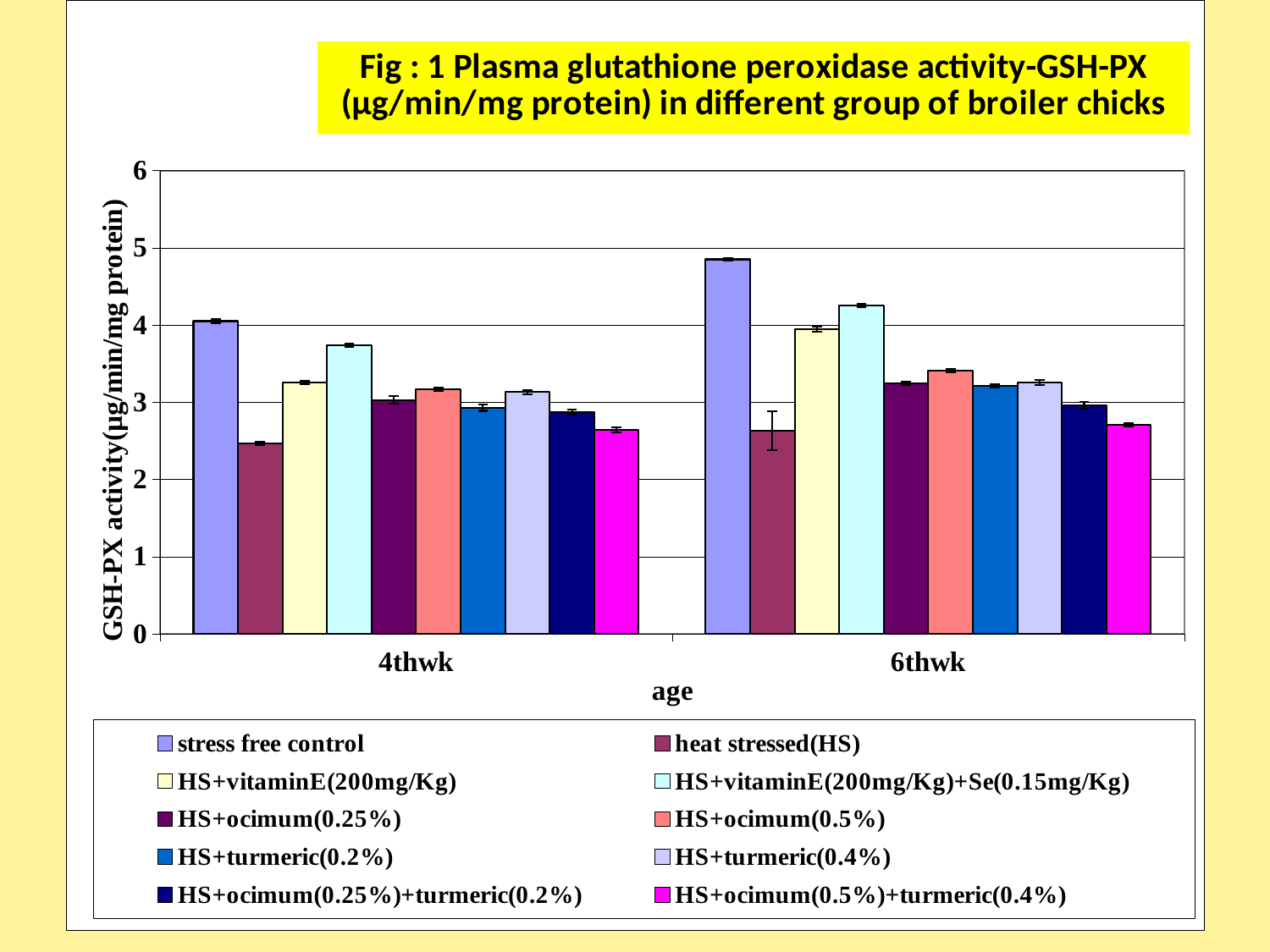
What kind of chart is shown on the slide? bar chart Which group has the highest GSH-PX activity at 4thwk? stress free control Does the value for stress free control rise or fall from 4thwk to 6thwk? rise Which is larger for stress free control: the value at 4thwk or at 6thwk? 6thwk Is the value for HS+vitaminE(200mg/Kg) at 4thwk greater or less than 3? greater Is the value for HS+vitaminE(200mg/Kg)+Se(0.15mg/Kg) at 6thwk greater or less than 4? greater Is the value for heat stressed(HS) at 4thwk greater or less than 3? less How many age categories are shown on the x axis? 2 What is the label of the x axis? age How many series does the legend list? 10 Which group has the highest GSH-PX activity at 6thwk? stress free control